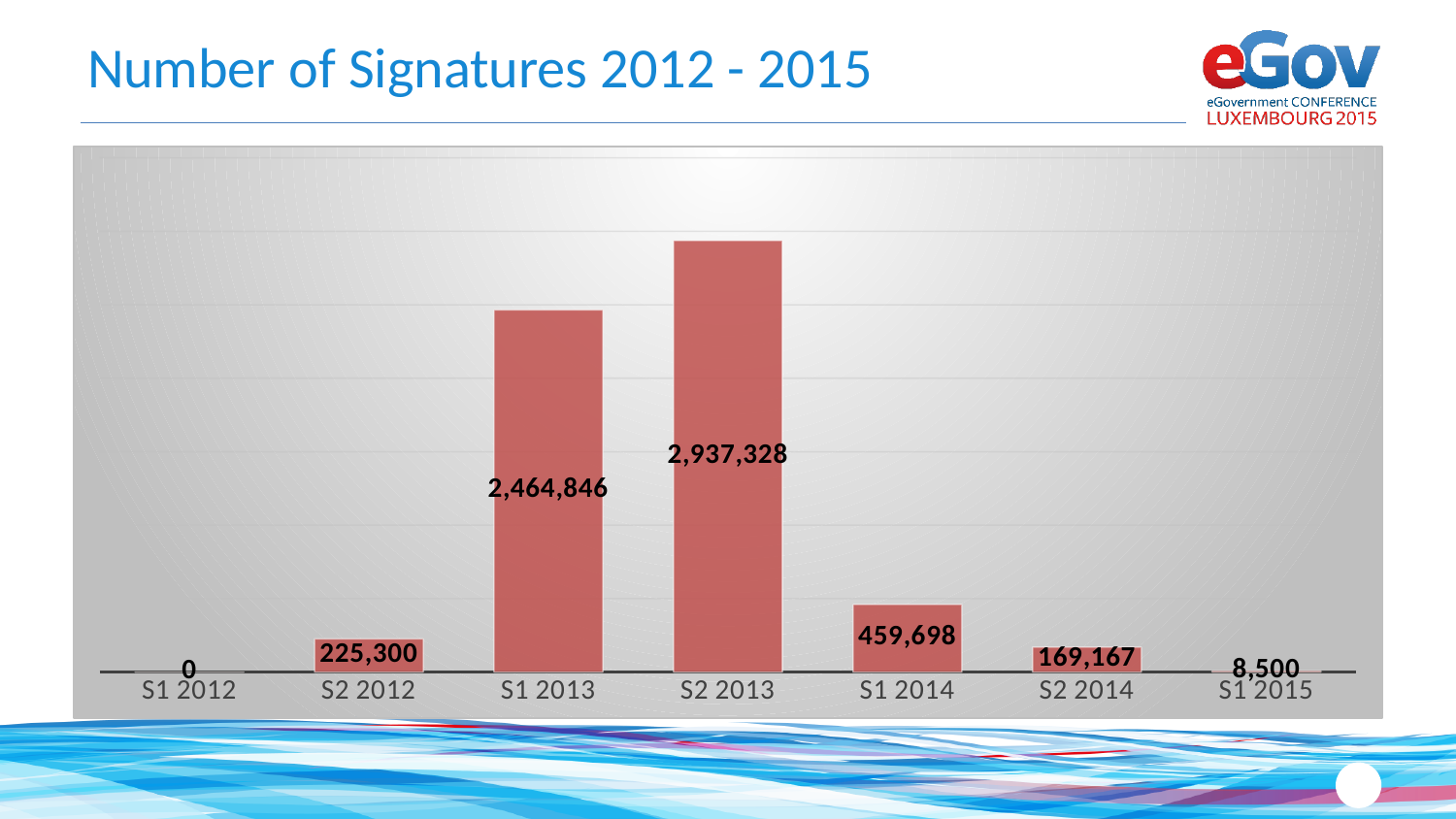
What is the number of signatures for S2 2013? 2,937,328 What is the difference in signatures between S2 2013 and S1 2013? 472,482 What is the difference in signatures between S1 2014 and S2 2014? 290,531 What is the title of the chart? Number of Signatures 2012 - 2015 Which has more signatures, S2 2012 or S2 2014? S2 2012 How many periods are shown on the x axis? 7 Which period has the lowest number of signatures? S1 2012 Which period has the highest number of signatures? S2 2013 What is the number of signatures for S1 2015? 8,500 What is the number of signatures for S1 2014? 459,698 What is the number of signatures for S2 2012? 225,300 What type of chart is shown on the slide? Bar chart